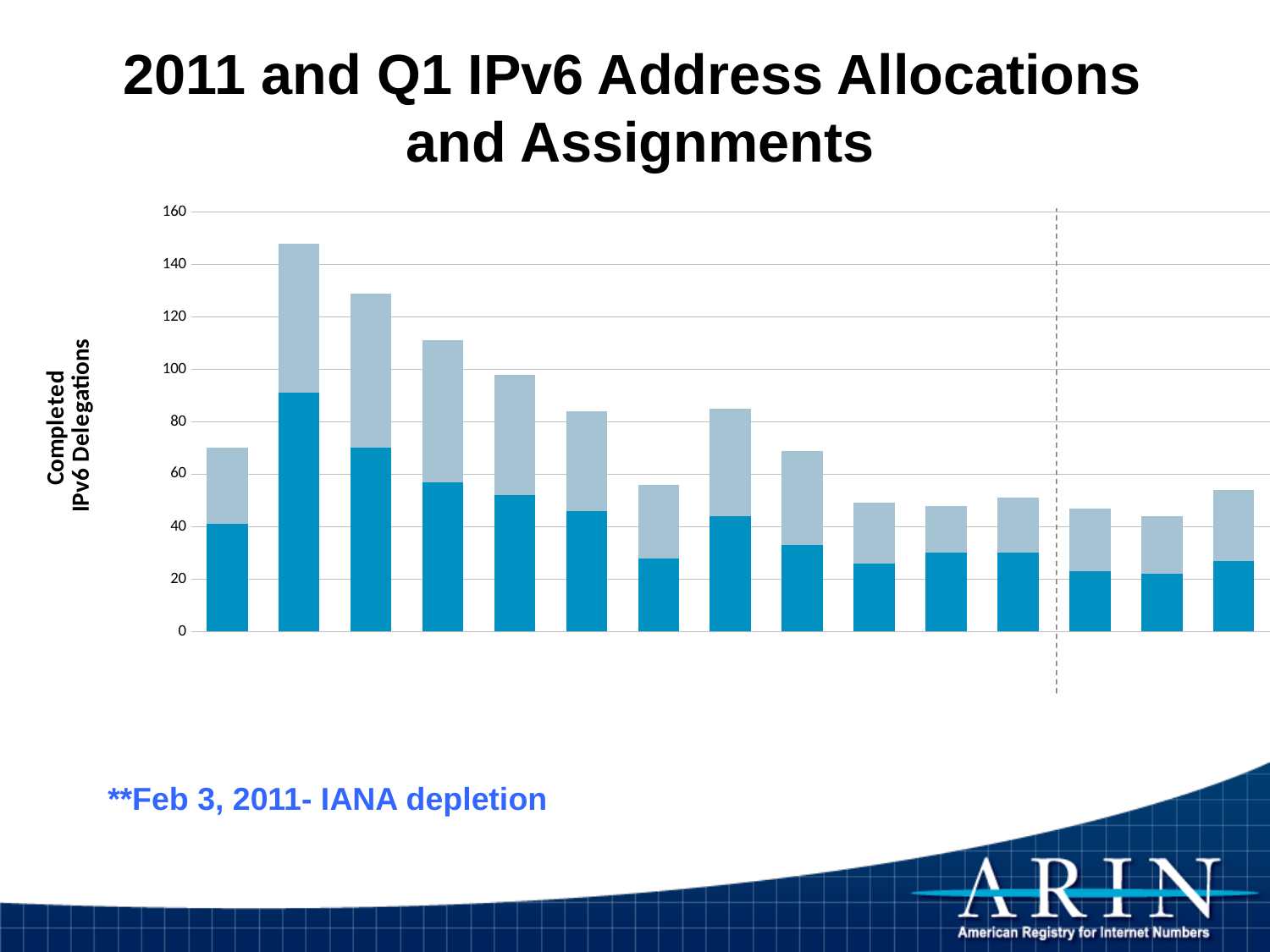
How many bars are plotted in the chart? 15 Is the total of the third bar from the left greater or less than 120? greater Is the total of the last bar on the right greater or less than 60? less Is the total of the second bar from the left greater or less than 140? greater Which has the larger total: the second bar from the left or the third bar from the left? The second bar What is the label on the vertical axis of the chart? Completed IPv6 Delegations What is the title of the slide containing the chart? 2011 and Q1 IPv6 Address Allocations and Assignments Which has the larger total: the first bar from the left or the last bar on the right? The first bar What kind of chart is shown on the slide? Stacked bar chart Which bar has the highest total, counting from the left? The second bar